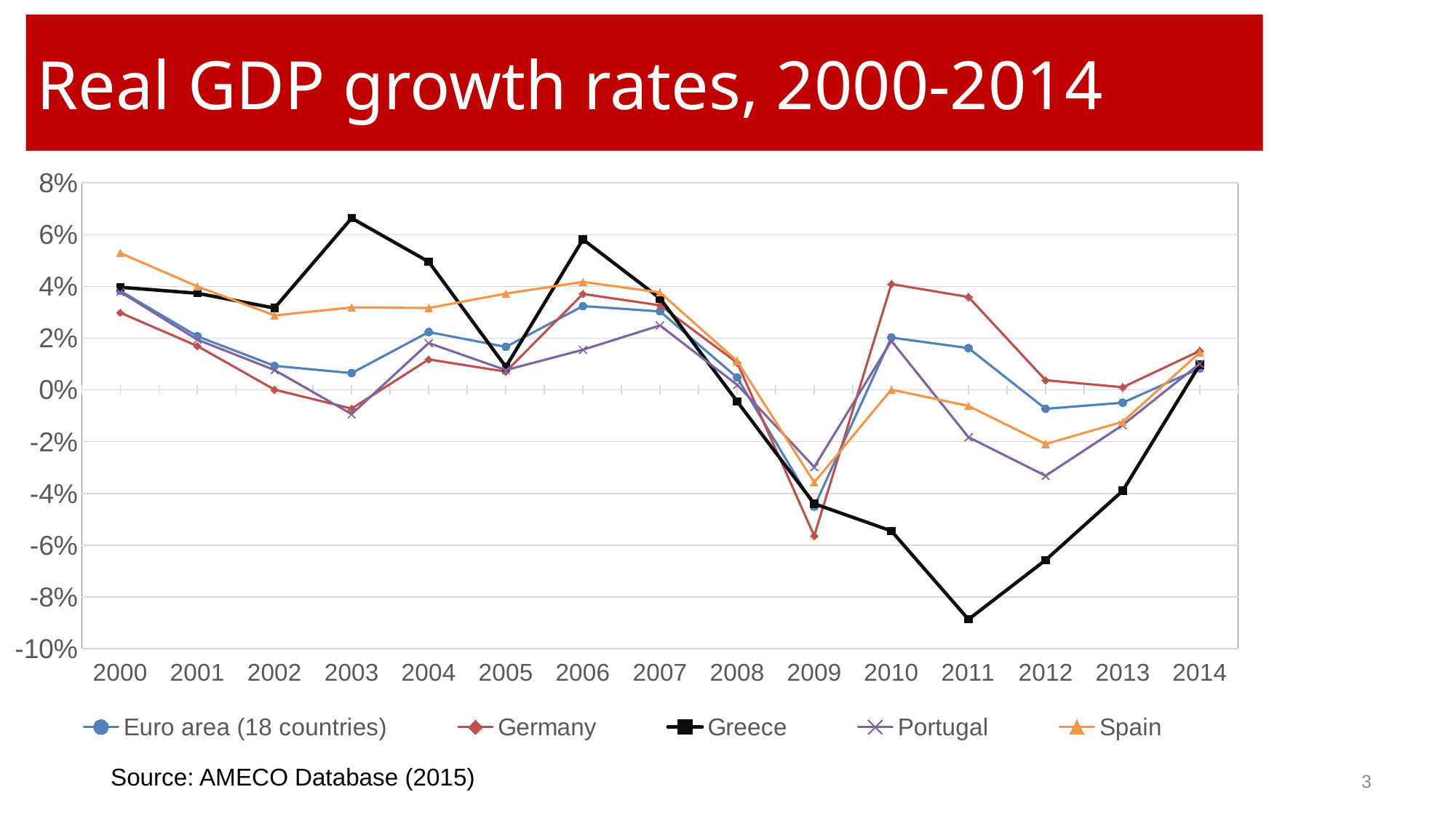
Which series has the highest value in 2010? Germany In which year does Greece reach its lowest value? 2011 Is the value for Greece in 2011 greater or less than -8%? less How many years are plotted along the x axis? 15 In 2009, which is larger: the value for Germany or the value for Portugal? Portugal What source is cited below the chart? AMECO Database (2015) What kind of chart is shown on the slide? line chart Does the Greece line rise or fall from 2007 to 2011? fall How many series does the legend list? 5 Is the value for Spain in 2000 greater or less than 4%? greater Is the value for Greece in 2003 greater or less than 6%? greater Which series has the lowest value in 2011? Greece